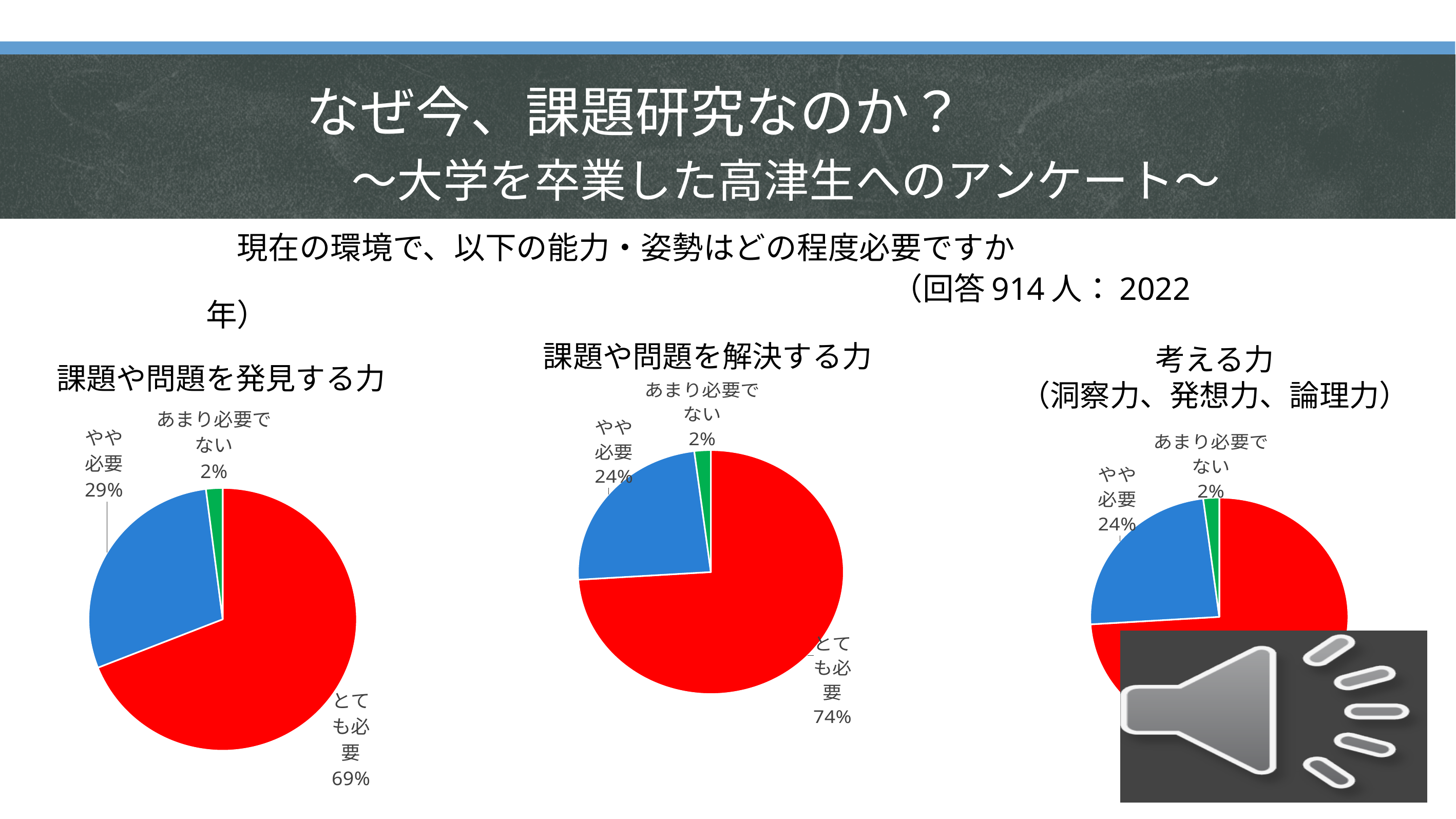
In the 課題や問題を発見する力 chart, which response has the largest slice? とても必要 In the 課題や問題を解決する力 chart, what share of respondents answered やや必要? 24% In the 考える力（洞察力、発想力、論理力） chart, what share of respondents answered あまり必要でない? 2% How many slices does the 課題や問題を解決する力 pie chart have? 3 What type of chart is used for 課題や問題を発見する力? Pie chart In the 課題や問題を解決する力 chart, what share of respondents answered とても必要? 74% In the 課題や問題を発見する力 chart, what is the difference between the とても必要 and やや必要 shares? 40% In the 課題や問題を発見する力 chart, what share of respondents answered やや必要? 29% In the 課題や問題を発見する力 chart, what share of respondents answered とても必要? 69% Which chart has the larger とても必要 share, 課題や問題を発見する力 or 課題や問題を解決する力? 課題や問題を解決する力 In the 考える力（洞察力、発想力、論理力） chart, what share of respondents answered やや必要? 24% In the 課題や問題を解決する力 chart, which response has the smallest slice? あまり必要でない